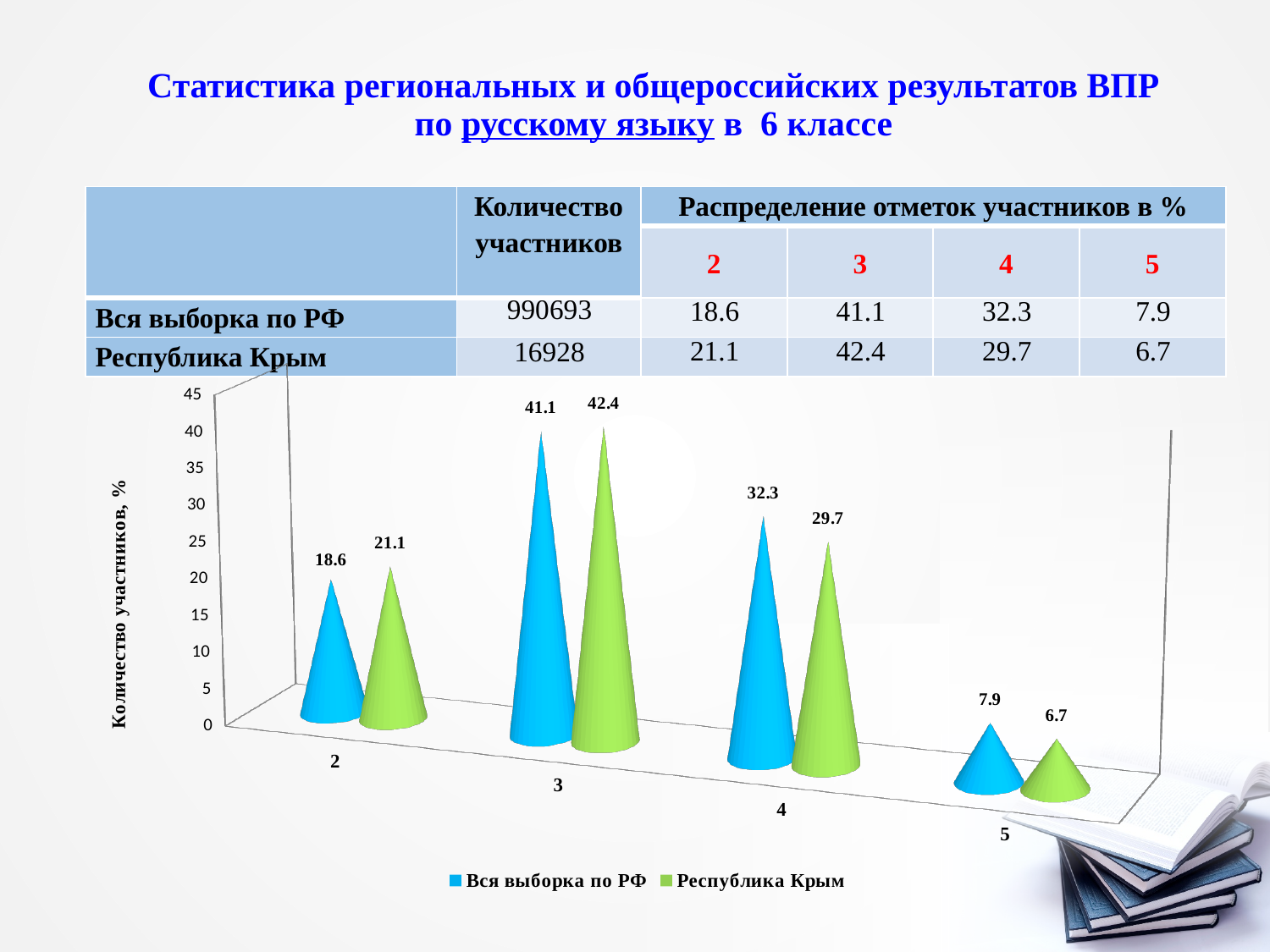
How many grade categories are shown on the x axis? 4 Which series has the larger value at grade 2, 'Вся выборка по РФ' or 'Республика Крым'? Республика Крым What is the value for 'Республика Крым' at grade 2? 21.1 Is the value for 'Вся выборка по РФ' at grade 4 greater or less than 30? greater Which grade has the highest value for 'Республика Крым'? 3 What is the difference between 'Вся выборка по РФ' and 'Республика Крым' at grade 4? 2.6 What is the value for 'Республика Крым' at grade 5? 6.7 What kind of chart is shown on the slide? bar chart What is the value for 'Вся выборка по РФ' at grade 3? 41.1 What is the label of the vertical axis? Количество участников, % How many series does the legend list? 2 Which grade has the lowest value for 'Вся выборка по РФ'? 5